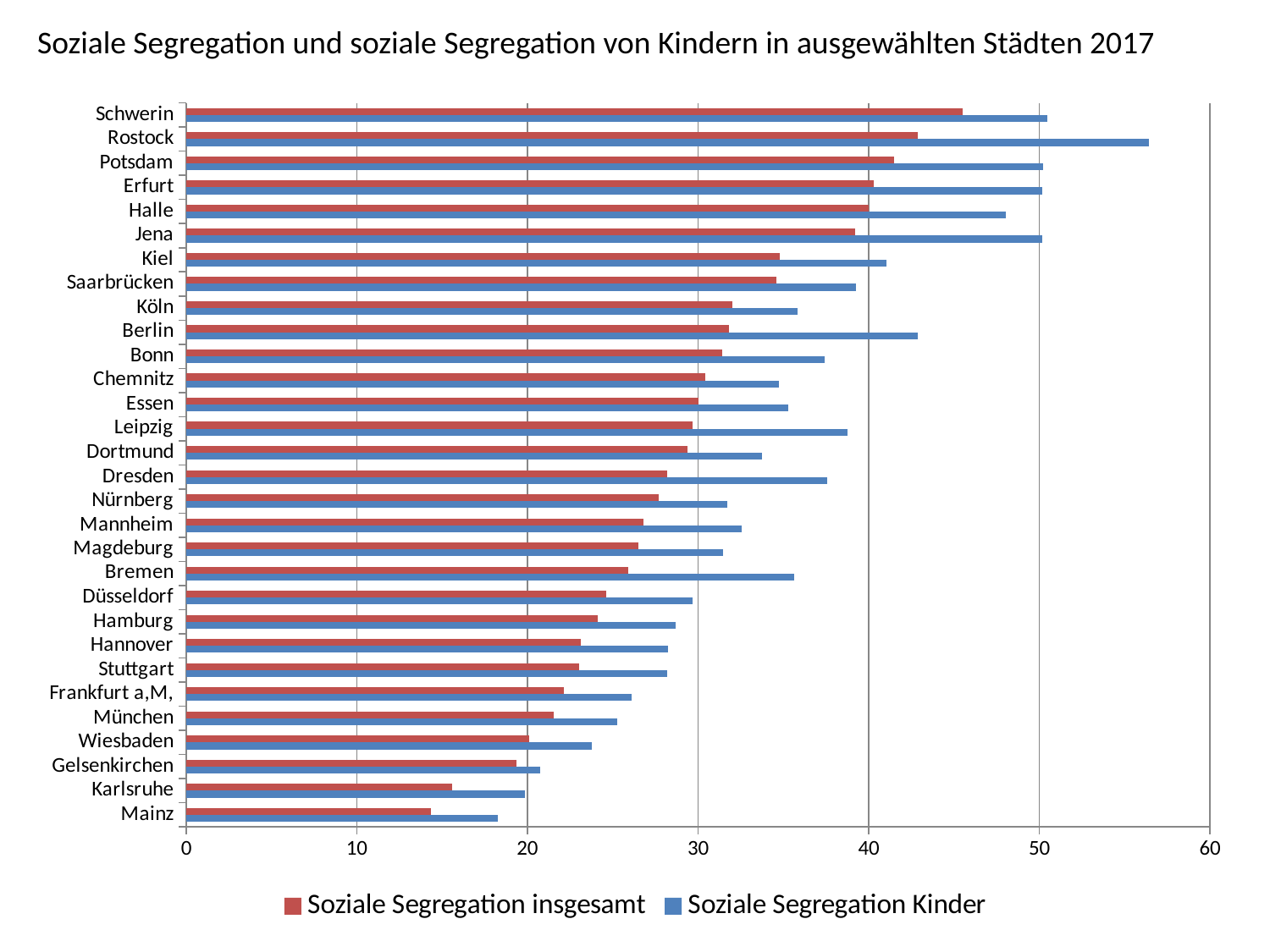
Is the value for Soziale Segregation insgesamt in Schwerin greater or less than 40? greater Is the value for Soziale Segregation Kinder in Mainz greater or less than 20? less What is the title of the chart? Soziale Segregation und soziale Segregation von Kindern in ausgewählten Städten 2017 Which city has the highest value for Soziale Segregation insgesamt? Schwerin Is the value for Soziale Segregation Kinder in Rostock greater or less than 50? greater How many series does the legend list? 2 Which city has the highest value for Soziale Segregation Kinder? Rostock Which city has the lowest value for Soziale Segregation insgesamt? Mainz Which is larger, the Soziale Segregation Kinder value for Berlin or for Bonn? Berlin What kind of chart is shown on the slide? bar chart How many cities are shown on the chart? 30